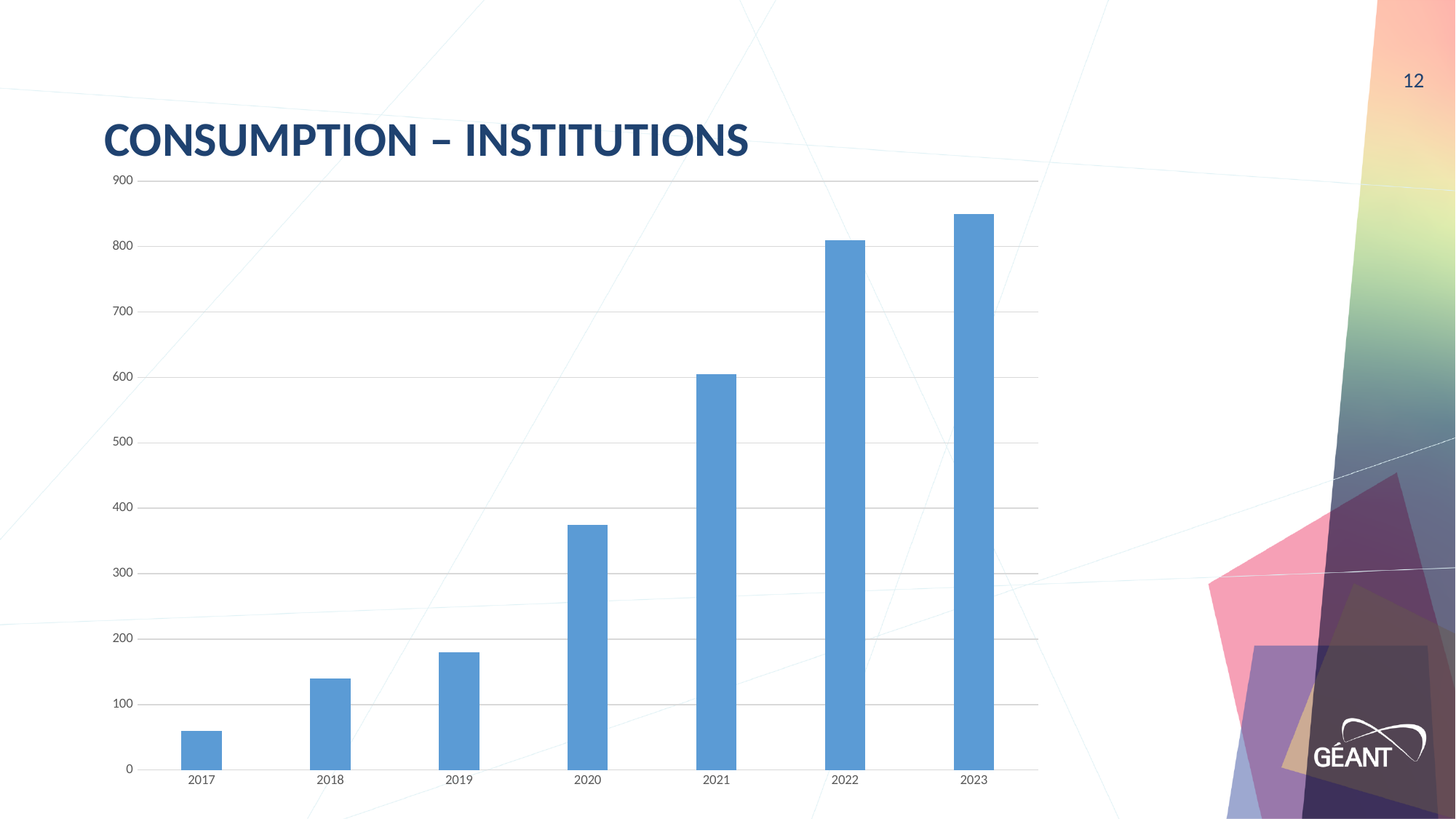
Is the value for 2017 greater or less than 100? less What is the title of the chart? CONSUMPTION – INSTITUTIONS Is the value for 2020 greater or less than 400? less How many years are shown on the x axis of the chart? 7 Do the values rise or fall from 2017 to 2023? rise Which year has the highest value in the chart? 2023 What kind of chart is shown on the slide? bar chart Which year has the lowest value in the chart? 2017 Is the value for 2018 greater or less than 100? greater Which is larger, the value for 2020 or the value for 2021? 2021